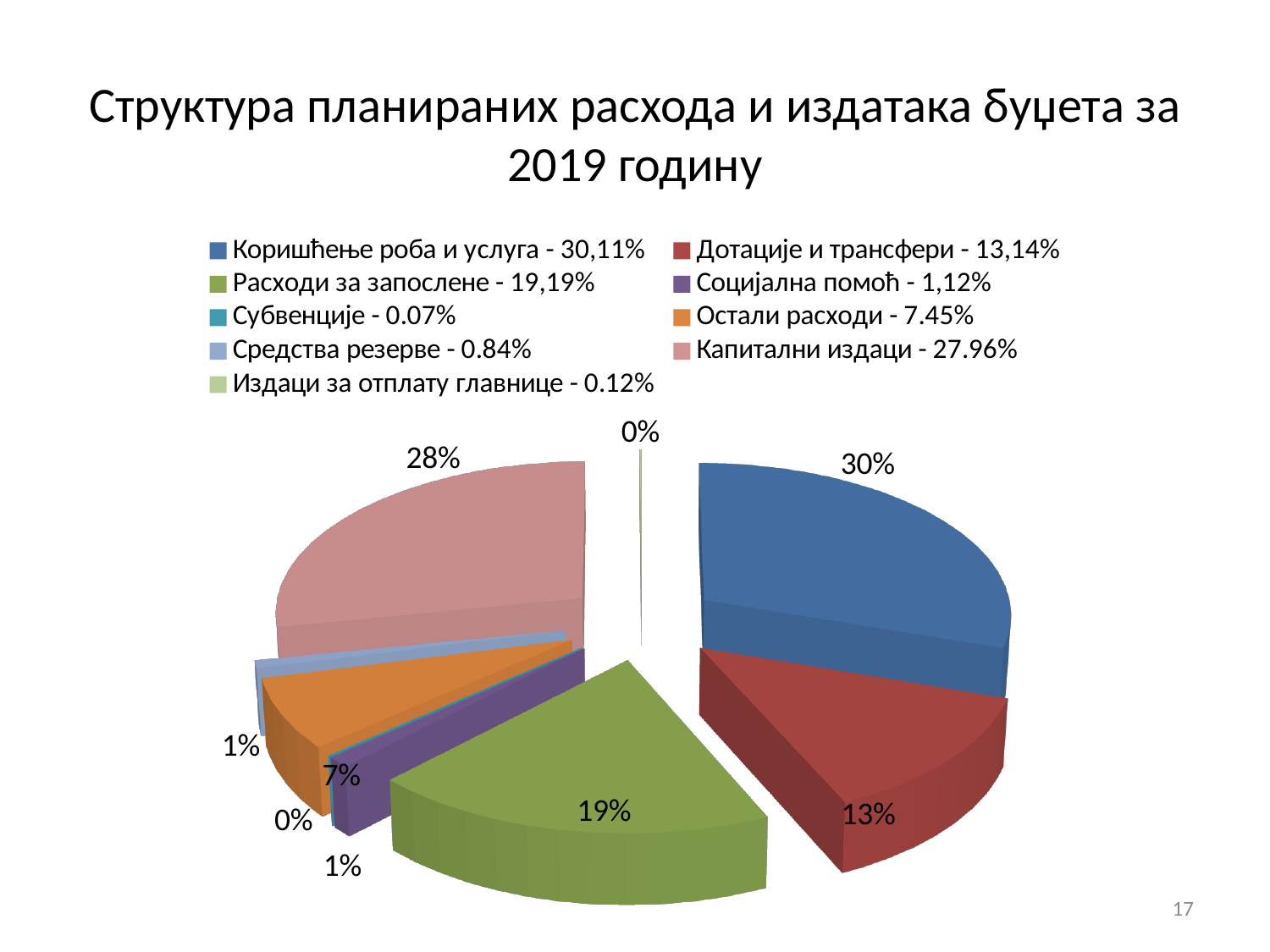
What percentage label is shown on the red slice of the pie? 13% What value does the legend give for Капитални издаци? 27.96% Which is larger, Расходи за запослене or Дотације и трансфери? Расходи за запослене What value does the legend give for Субвенције? 0.07% What kind of chart is shown on the slide? pie chart What percentage label is shown on the green slice of the pie? 19% How many categories does the legend of the pie chart list? 9 What value does the legend give for Коришћење роба и услуга? 30,11% What is the difference between the legend values for Расходи за запослене and Дотације и трансфери? 6,05% Which category has the smallest share of the pie? Субвенције What is the title of the chart on the slide? Структура планираних расхода и издатака буџета за 2019 годину Which category has the largest share of the pie? Коришћење роба и услуга